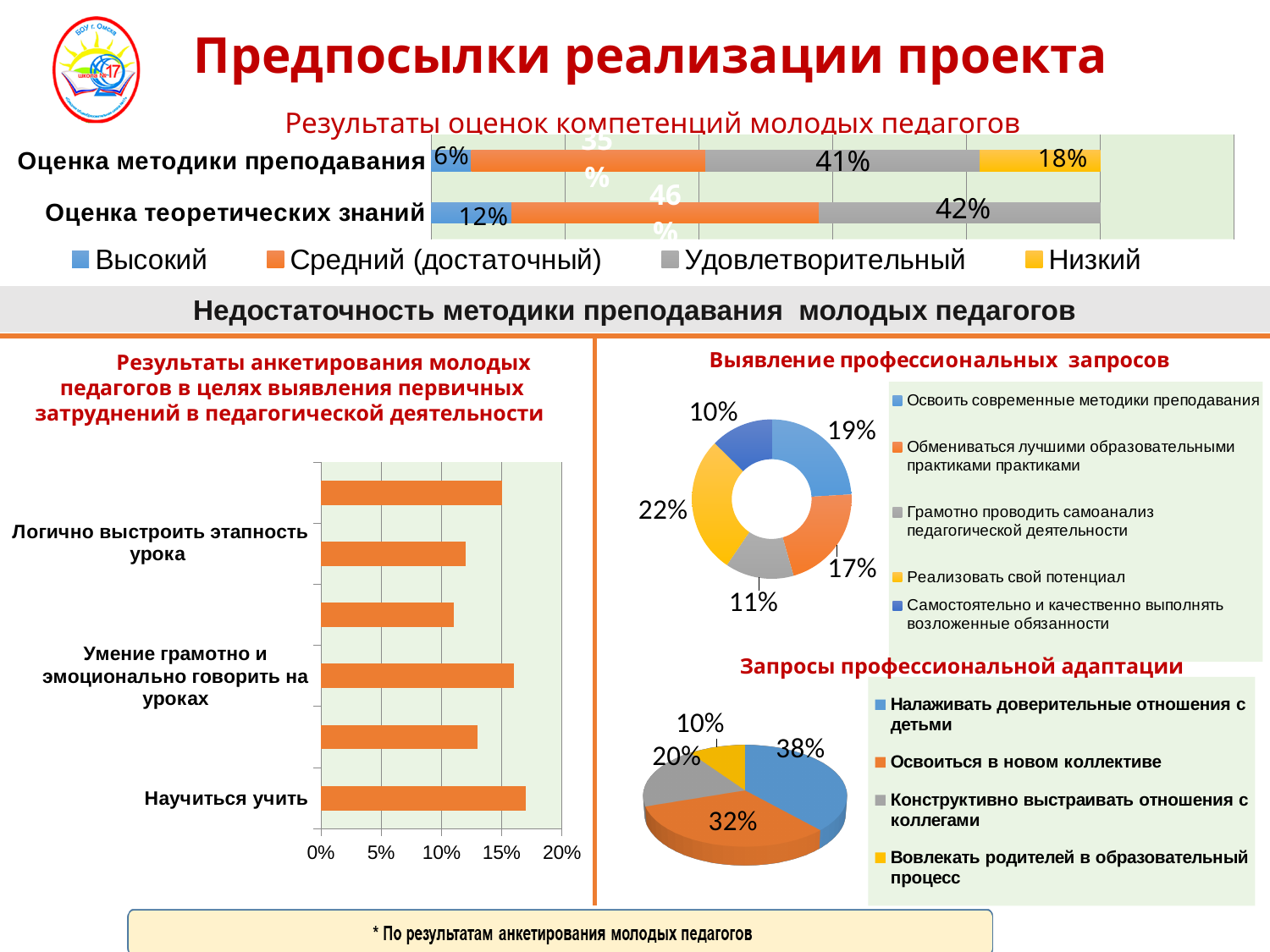
In the stacked bar chart 'Результаты оценок компетенций молодых педагогов', how many series does the legend list? 4 In the donut chart 'Выявление профессиональных запросов', what is the share for 'Грамотно проводить самоанализ педагогической деятельности'? 11% In the stacked bar chart 'Результаты оценок компетенций молодых педагогов', what is the 'Высокий' value for 'Оценка теоретических знаний'? 12% In the bar chart 'Результаты анкетирования молодых педагогов...' on the left, is the value for 'Научиться учить' greater or less than 15%? greater In the stacked bar chart 'Результаты оценок компетенций молодых педагогов', what is the 'Удовлетворительный' value for 'Оценка методики преподавания'? 41% In the bar chart 'Результаты анкетирования молодых педагогов...' on the left, is the value for 'Логично выстроить этапность урока' greater or less than 15%? less In the pie chart 'Запросы профессиональной адаптации', what is the share for 'Освоиться в новом коллективе'? 32% In the stacked bar chart 'Результаты оценок компетенций молодых педагогов', what is the difference between the 'Высокий' values for 'Оценка теоретических знаний' and 'Оценка методики преподавания'? 6% In the bar chart 'Результаты анкетирования молодых педагогов...' on the left, how many bars are plotted? 6 In the stacked bar chart 'Результаты оценок компетенций молодых педагогов', what is the 'Низкий' value for 'Оценка методики преподавания'? 18% In the pie chart 'Запросы профессиональной адаптации', which category has the smallest share? Вовлекать родителей в образовательный процесс In the donut chart 'Выявление профессиональных запросов', which category has the largest share? Реализовать свой потенциал